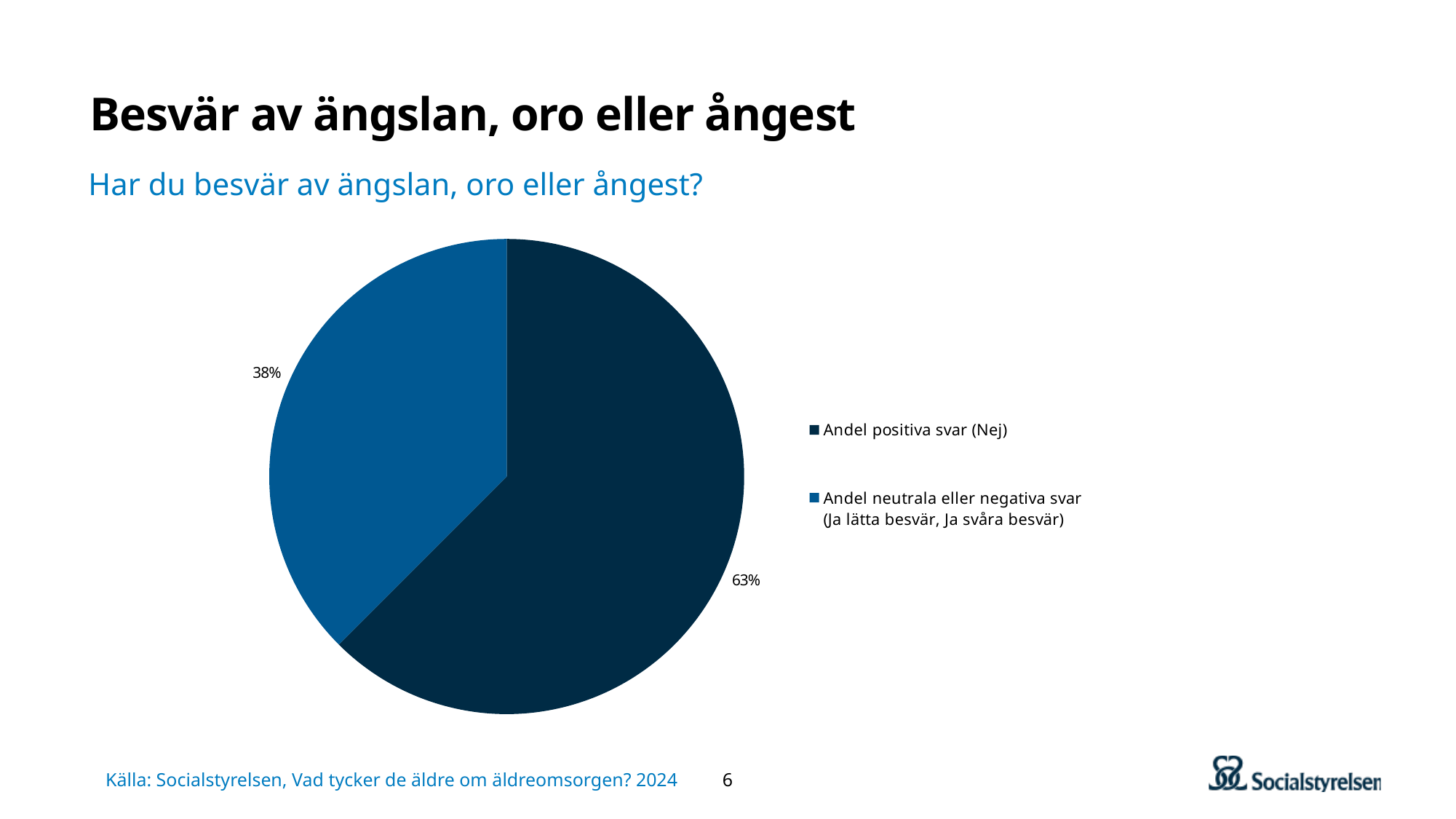
What is the difference in percentage points between the two slices of the pie? 25 Which slice of the pie is the largest? Andel positiva svar (Nej) What kind of chart is shown on the slide? pie chart What share of the pie is labelled "Andel neutrala eller negativa svar (Ja lätta besvär, Ja svåra besvär)"? 38% How many slices does the pie chart have? 2 Which legend entry is shown in the darker blue colour? Andel positiva svar (Nej) What question is shown as the chart's subtitle? Har du besvär av ängslan, oro eller ångest? Which is larger: the share of positive answers (Nej) or the share of neutral or negative answers? Andel positiva svar (Nej) Which slice of the pie is the smallest? Andel neutrala eller negativa svar (Ja lätta besvär, Ja svåra besvär) How many entries does the legend list? 2 What share of the pie is labelled "Andel positiva svar (Nej)"? 63%